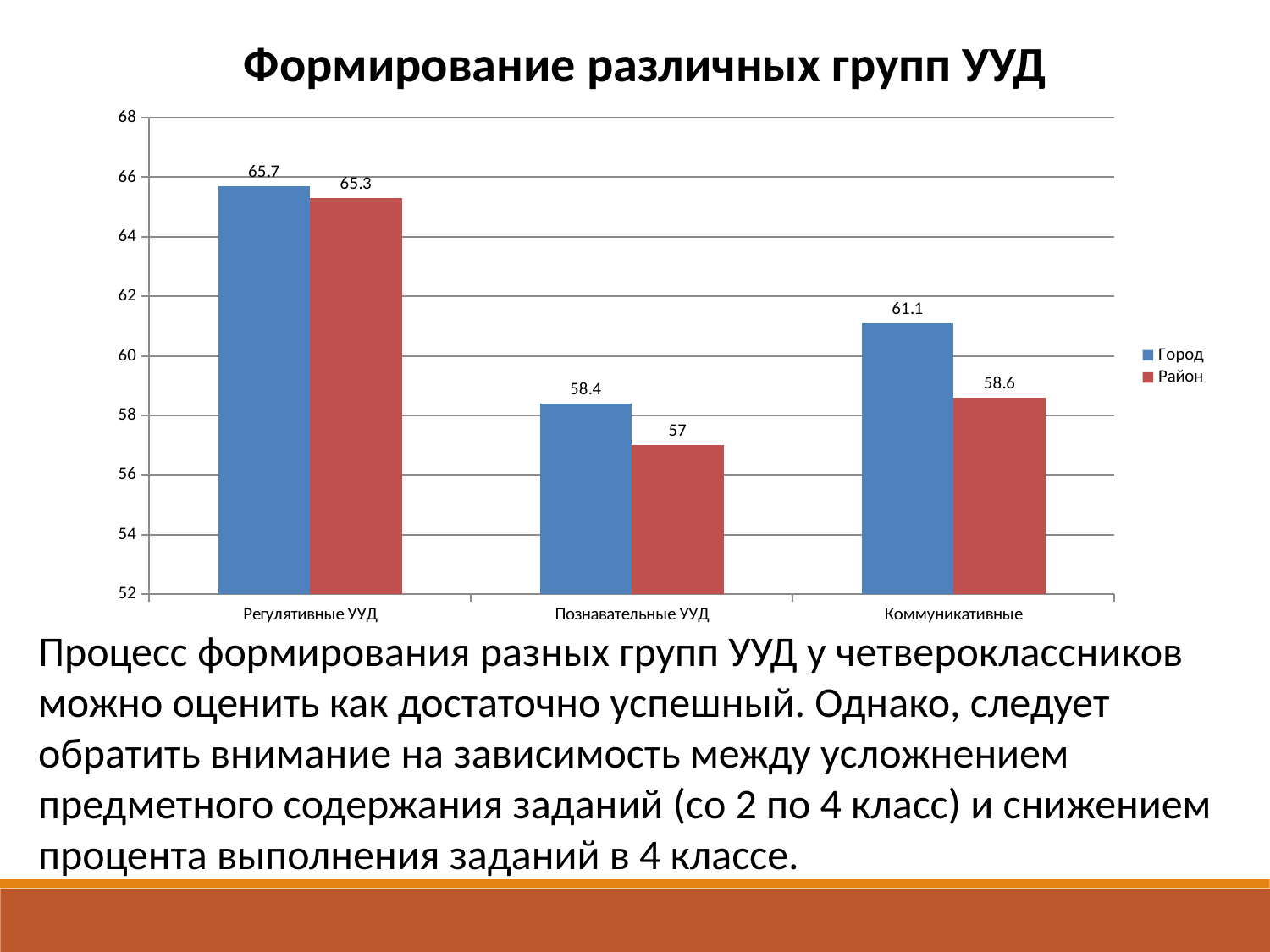
What is the value for Район in the Коммуникативные category? 58.6 What kind of chart is shown on the slide? Bar chart How many categories are shown on the x axis? 3 What is the difference between Город and Район in the Коммуникативные category? 2.5 What is the difference between Город and Район in the Познавательные УУД category? 1.4 How many series does the legend list? 2 What is the title of the chart? Формирование различных групп УУД What is the value for Район in the Познавательные УУД category? 57 Which category has the lowest value for the Район series? Познавательные УУД What is the value for Город in the Регулятивные УУД category? 65.7 Which is larger in the Регулятивные УУД category, Город or Район? Город Which category has the highest value for the Город series? Регулятивные УУД